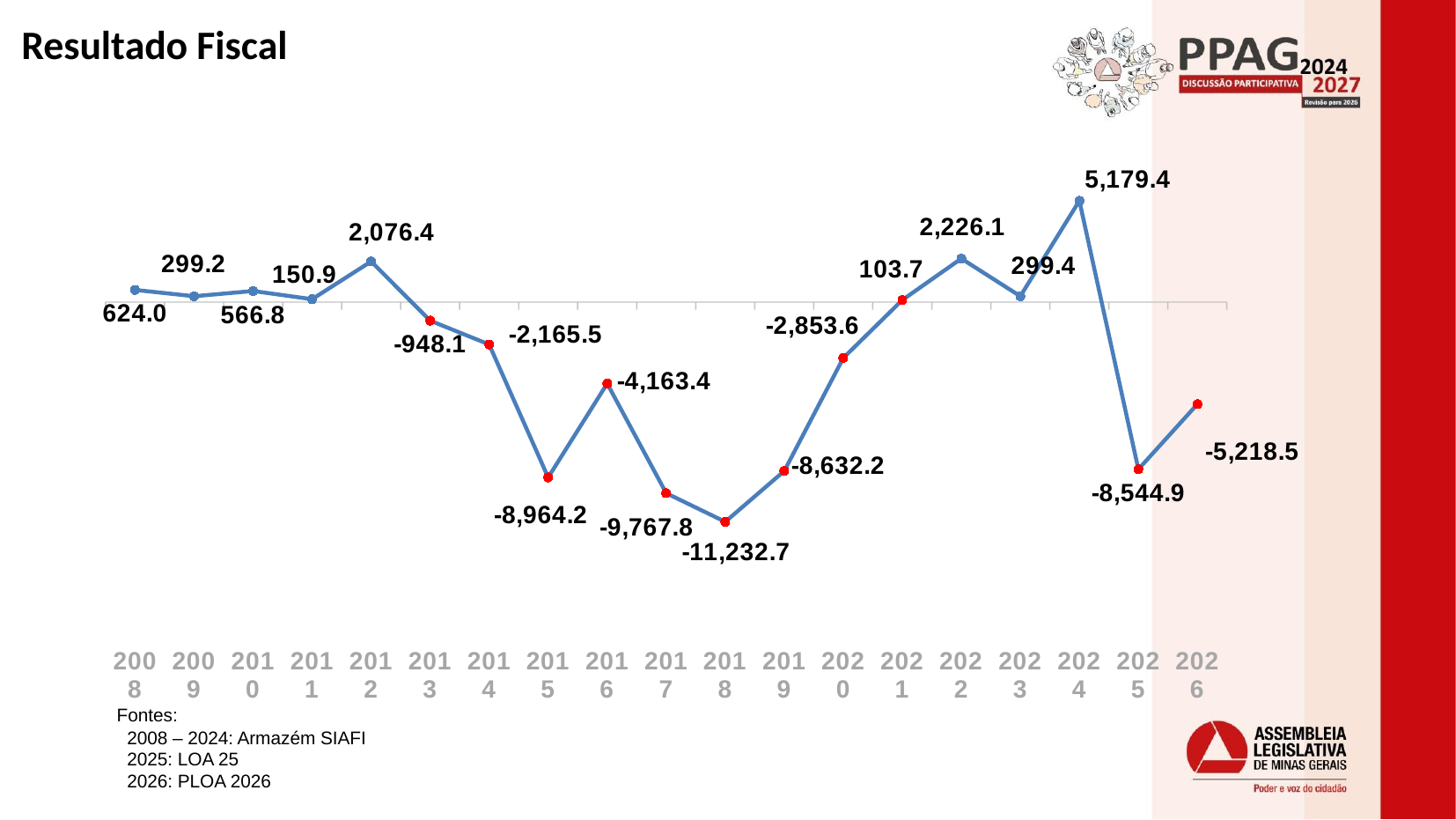
Which year has the highest value? 2024 What is the title of the slide? Resultado Fiscal Does the value rise or fall from 2024 to 2025? Fall What is the difference between the values for 2024 and 2022? 2,953.3 What kind of chart is shown on the slide? Line chart What is the value for 2026? -5,218.5 What is the value for 2024? 5,179.4 What is the value for 2012? 2,076.4 Which year has the lowest value? 2018 How many years are plotted on the chart? 19 What is the value for 2018? -11,232.7 Which is larger, the value for 2015 or the value for 2016? 2016